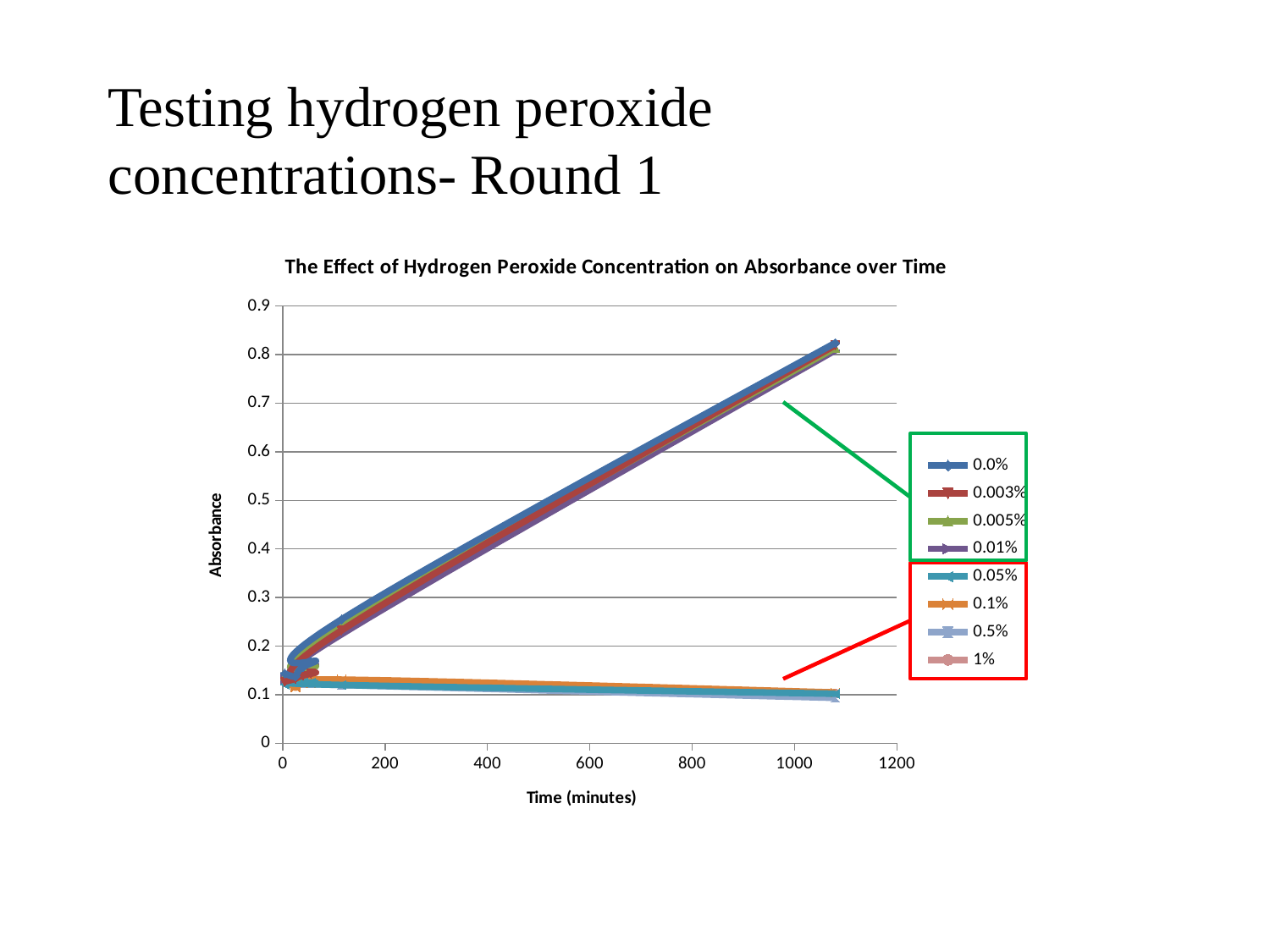
At 800 minutes, which series has the larger absorbance, 0.1% or 0.01%? 0.01% What is the label of the x axis of the chart? Time (minutes) Is the absorbance for the 0.003% series at 600 minutes greater or less than 0.4? greater Does the absorbance for the 0.0% series rise or fall as time increases? Rise At 1000 minutes, which series has the larger absorbance, 0.0% or 0.5%? 0.0% Does the absorbance for the 1% series rise or fall as time increases? Fall What kind of chart is shown on the slide? Line chart How many series does the chart's legend list? 8 What is the highest value shown on the y axis of the chart? 0.9 Is the absorbance for the 0.0% series at 1000 minutes greater or less than 0.6? greater Is the absorbance for the 1% series at 1000 minutes greater or less than 0.2? less What is the title of the chart? The Effect of Hydrogen Peroxide Concentration on Absorbance over Time